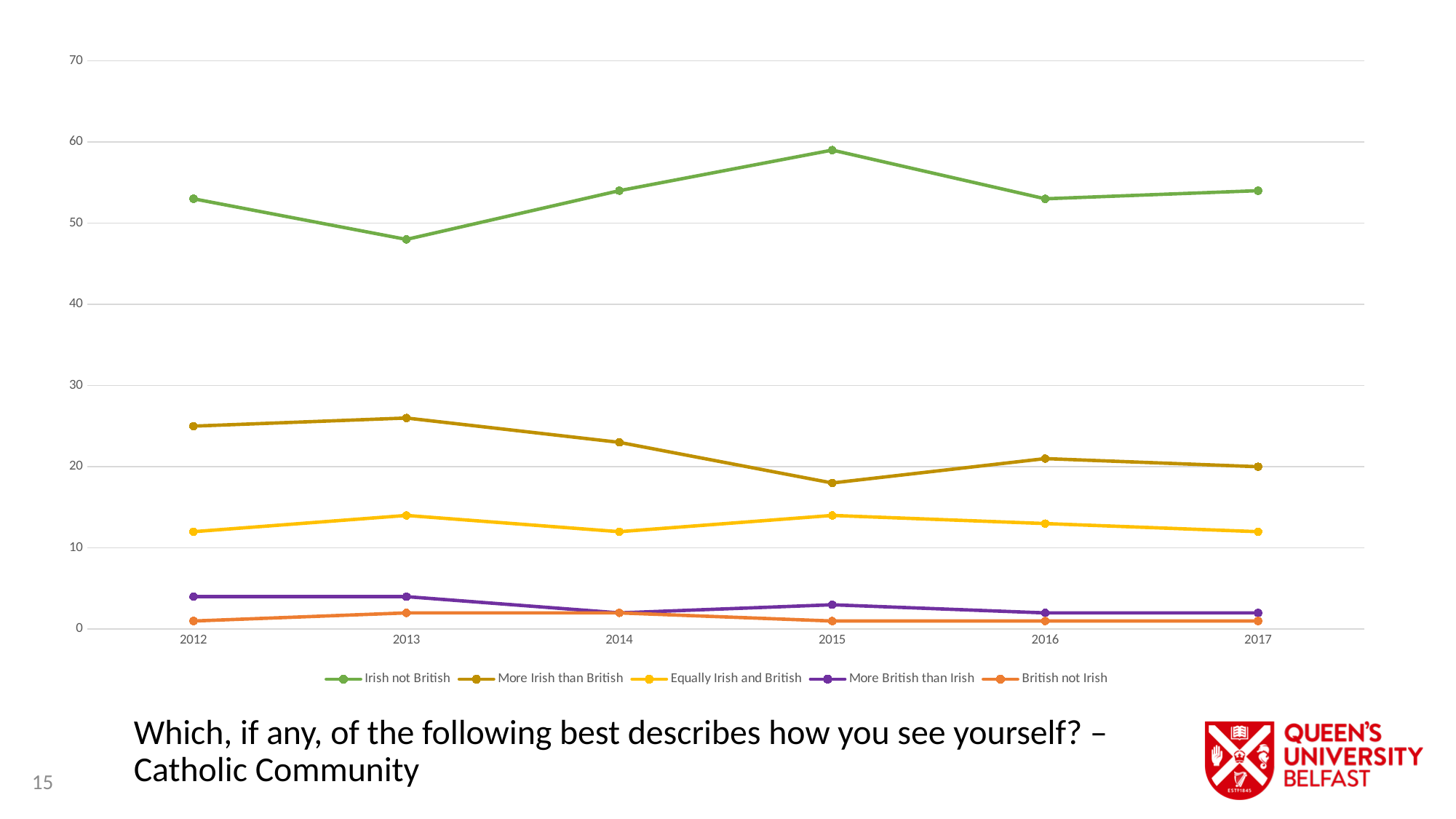
What kind of chart is shown on the slide? Line chart Is the value for More Irish than British in 2015 greater or less than 20? less Is the value for Irish not British in 2015 greater or less than 50? greater In which year is the value for Irish not British lowest? 2013 Is the value for More Irish than British in 2012 greater or less than 20? greater In which year is the value for More Irish than British lowest? 2015 How many series does the legend list? 5 Does the value for More Irish than British rise or fall from 2013 to 2015? fall In which year is the value for Irish not British highest? 2015 How many years are shown along the x axis? 6 In 2012, which is larger: Irish not British or More Irish than British? Irish not British